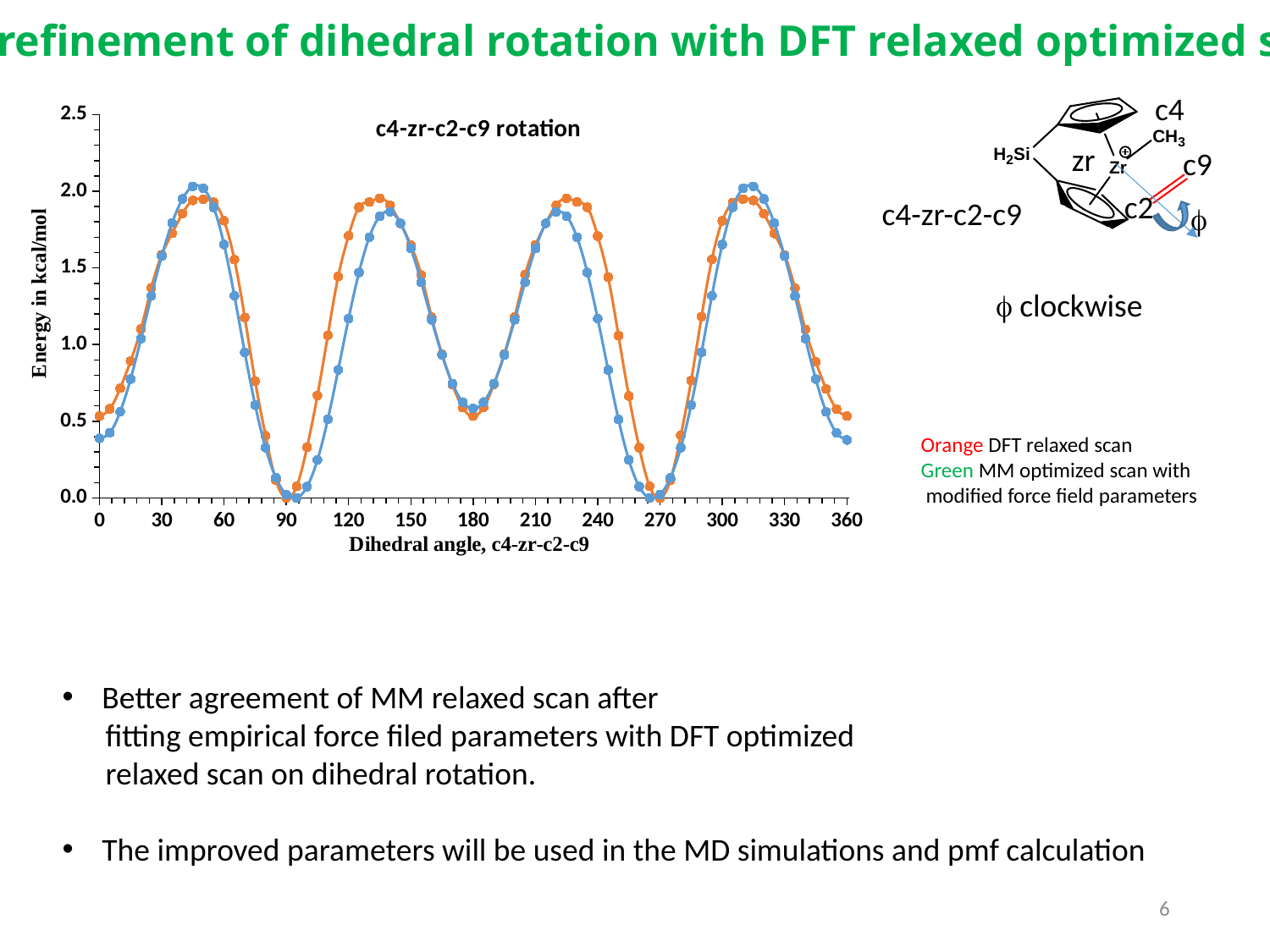
Is the value of the blue series at a dihedral angle of 315 greater or less than 1.5? greater Is the value of the blue series at a dihedral angle of 0 greater or less than 0.5? less Do the values of the orange series rise or fall as the dihedral angle goes from 45 to 90? fall What is the title of the chart? c4-zr-c2-c9 rotation What is the label of the y axis of the chart? Energy in kcal/mol Is the value of the orange series at a dihedral angle of 270 greater or less than 0.5? less How many data series are plotted in the chart? 2 Do the values of the blue series rise or fall as the dihedral angle goes from 0 to 45? rise At a dihedral angle of 120, which series has the larger value, orange or blue? orange What kind of chart is shown on the slide? line chart